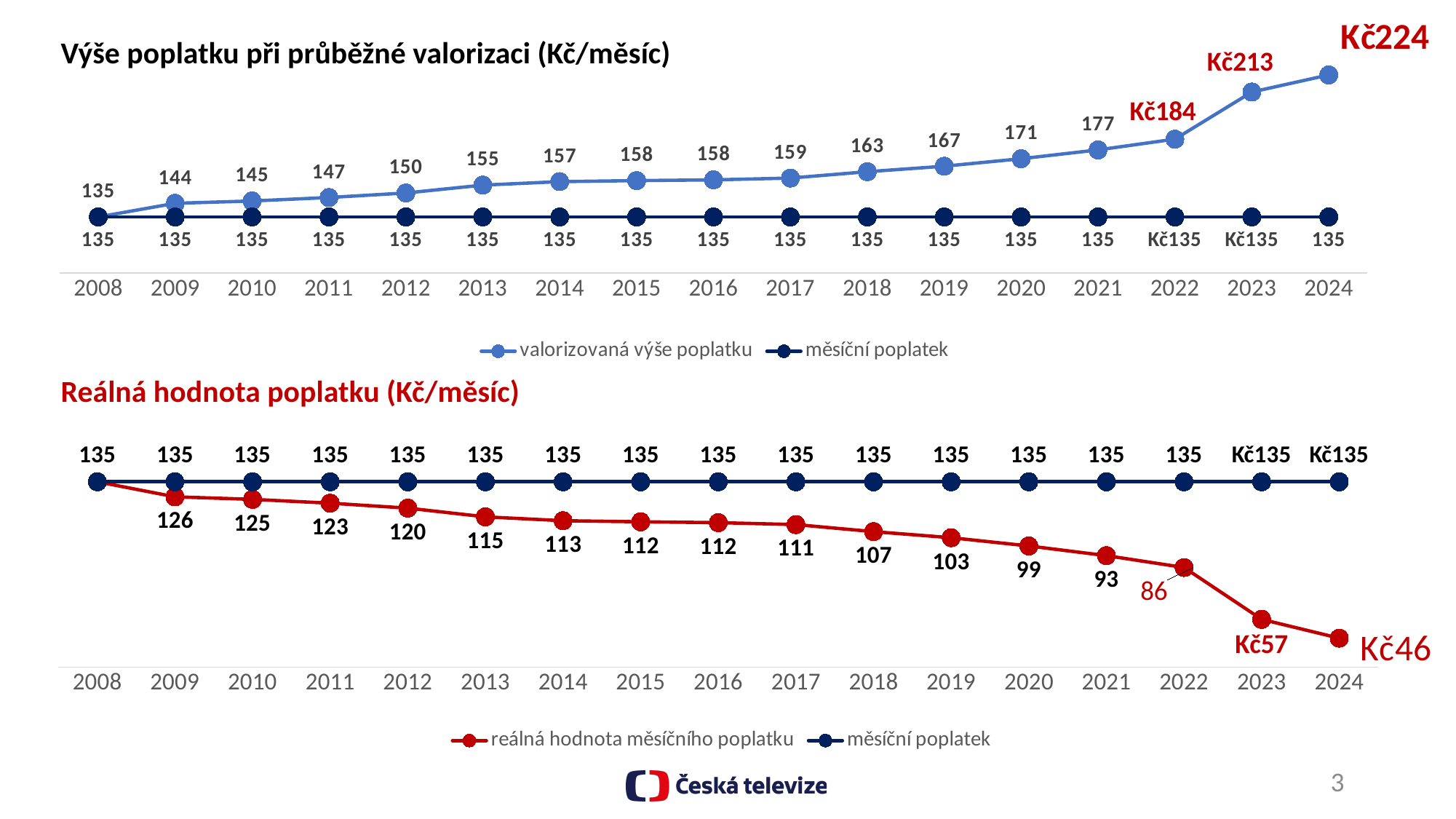
In the chart 'Výše poplatku při průběžné valorizaci (Kč/měsíc)', in which year is 'valorizovaná výše poplatku' highest? 2024 In the chart 'Výše poplatku při průběžné valorizaci (Kč/měsíc)', what is the value of 'valorizovaná výše poplatku' for 2013? 155 What type of chart is 'Reálná hodnota poplatku (Kč/měsíc)'? line chart In the chart 'Výše poplatku při průběžné valorizaci (Kč/měsíc)', what is the value of 'valorizovaná výše poplatku' for 2024? Kč224 In the chart 'Reálná hodnota poplatku (Kč/měsíc)', which is larger: 'reálná hodnota měsíčního poplatku' in 2012 or in 2019? 2012 In the chart 'Reálná hodnota poplatku (Kč/měsíc)', what is the value of 'reálná hodnota měsíčního poplatku' for 2018? 107 In the chart 'Reálná hodnota poplatku (Kč/měsíc)', what is the value of 'reálná hodnota měsíčního poplatku' for 2023? Kč57 How many years are shown on the x axis of the chart 'Reálná hodnota poplatku (Kč/měsíc)'? 17 In the chart 'Výše poplatku při průběžné valorizaci (Kč/měsíc)', what is the difference between 'valorizovaná výše poplatku' in 2020 and in 2019? 4 How many series does the legend of the chart 'Výše poplatku při průběžné valorizaci (Kč/měsíc)' list? 2 In the chart 'Reálná hodnota poplatku (Kč/měsíc)', in which year is 'reálná hodnota měsíčního poplatku' lowest? 2024 In the chart 'Výše poplatku při průběžné valorizaci (Kč/měsíc)', does 'valorizovaná výše poplatku' rise or fall from 2008 to 2024? rise